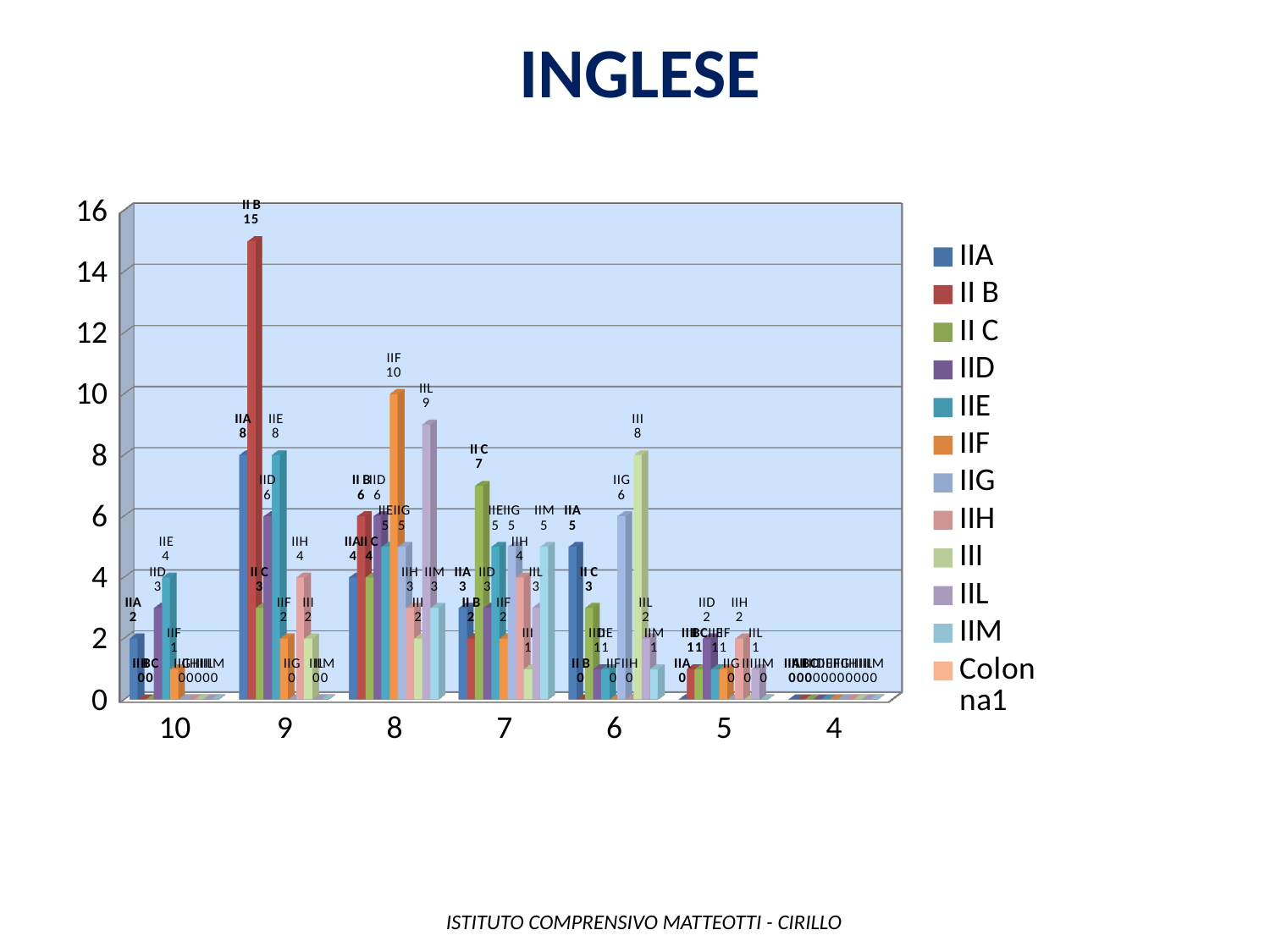
Which series has the highest bar in category 9? II B What is the difference between the II B value and the IIA value in category 9? 7 How many series does the legend list? 12 What is the value for II C in category 7? 7 What is the title of the chart? INGLESE In category 8, which is larger: the value for IIF or the value for IIL? IIF Which series has the highest bar in category 8? IIF What kind of chart is shown on the slide? bar chart What is the value for II B in category 9? 15 What is the value for III in category 6? 8 How many categories are shown on the x axis? 7 What is the value for IIF in category 8? 10